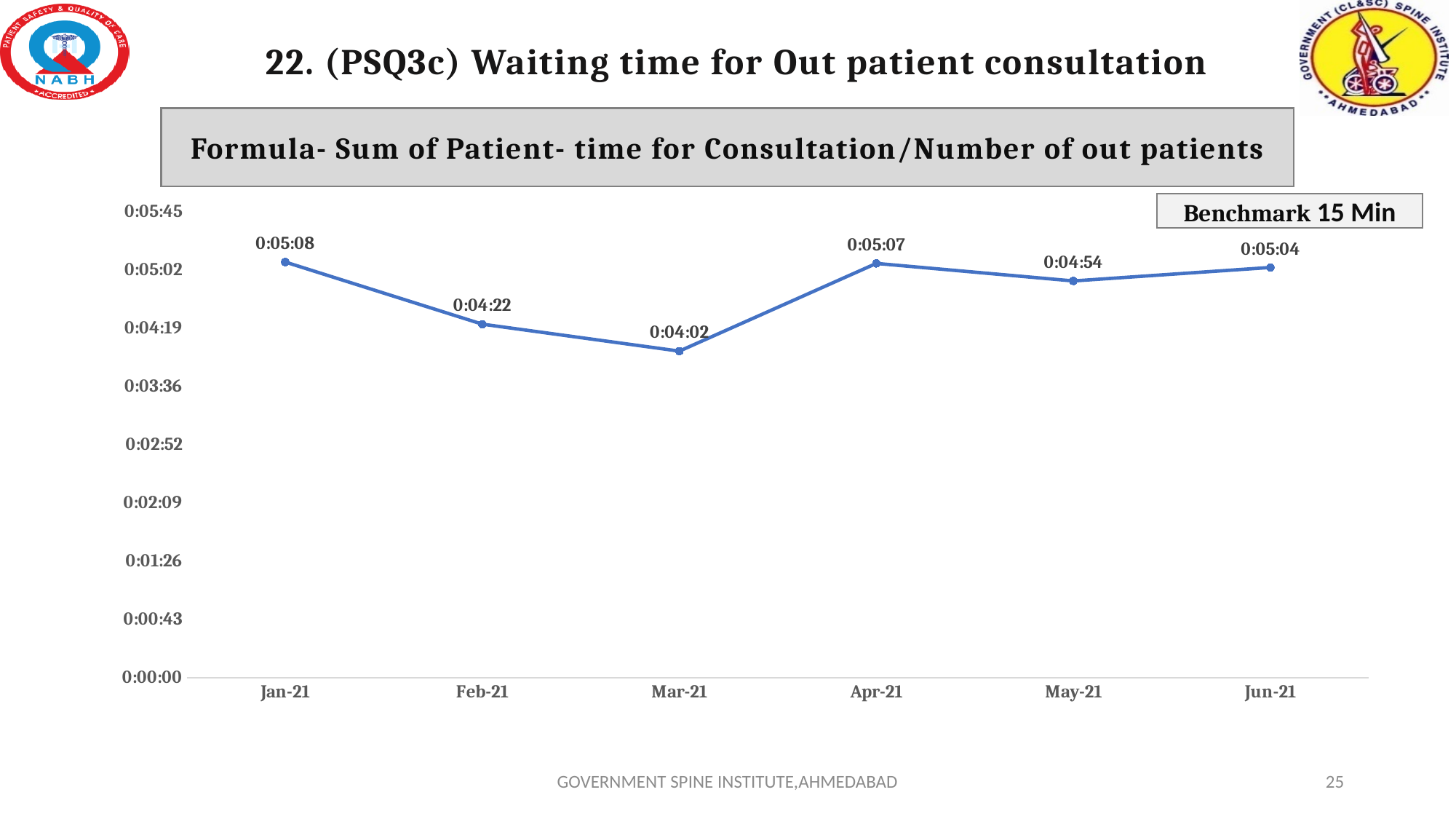
What is the waiting time for out patient consultation in Jun-21? 0:05:04 What is the waiting time for out patient consultation in Mar-21? 0:04:02 What type of chart is shown on the slide? line chart Which month has the higher waiting time, May-21 or Jun-21? Jun-21 What is the waiting time for out patient consultation in May-21? 0:04:54 What benchmark is stated on the slide for the waiting time? 15 Min Which month has the lowest waiting time for out patient consultation? Mar-21 Which month has the higher waiting time, Feb-21 or Apr-21? Apr-21 What is the waiting time for out patient consultation in Jan-21? 0:05:08 By how many seconds is the waiting time in Jan-21 greater than in Feb-21? 46 seconds How many months are plotted on the chart? 6 Does the waiting time rise or fall from Jan-21 to Mar-21? fall